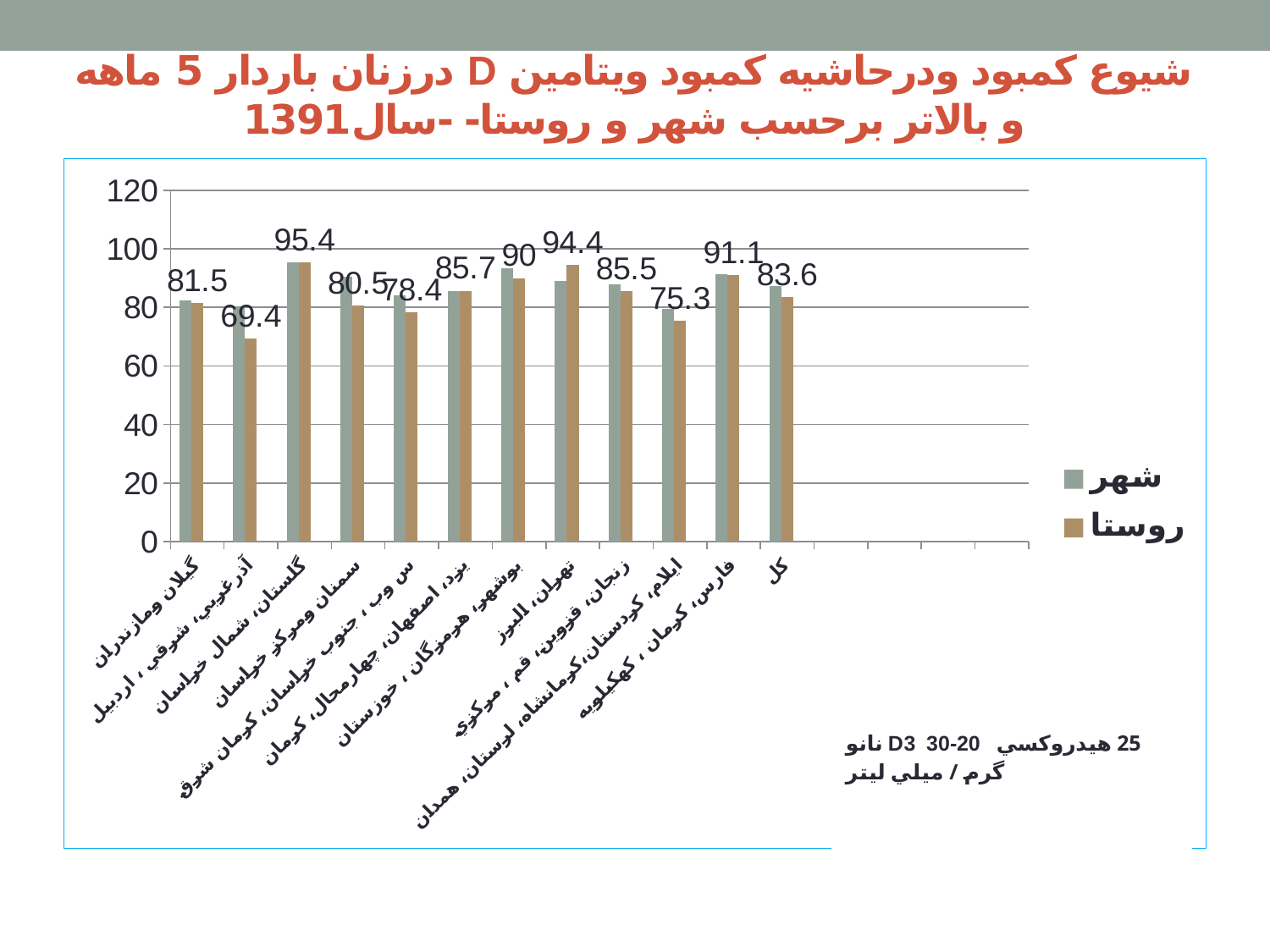
What are the two legend entries of the chart? شهر and روستا What is the labelled value for روستا in the کل group? 83.6 How many series does the legend list? 2 Which category group has the lowest labelled روستا value? آذرغربی، شرقی ، اردبیل Which has the larger labelled روستا value: فارس، کرمان ، کهکیلویه or ایلام، کردستان،کرمانشاه، لرستان، همدان? فارس، کرمان ، کهکیلویه How many category groups are plotted along the x axis? 12 What kind of chart is shown on the slide? bar chart What is the labelled value for روستا in the گلستان، شمال خراسان group? 95.4 Which category group has the highest labelled روستا value? گلستان، شمال خراسان What is the labelled value for روستا in the تهران، البرز group? 94.4 What is the difference between the labelled روستا values for گلستان، شمال خراسان and آذرغربی، شرقی ، اردبیل? 26